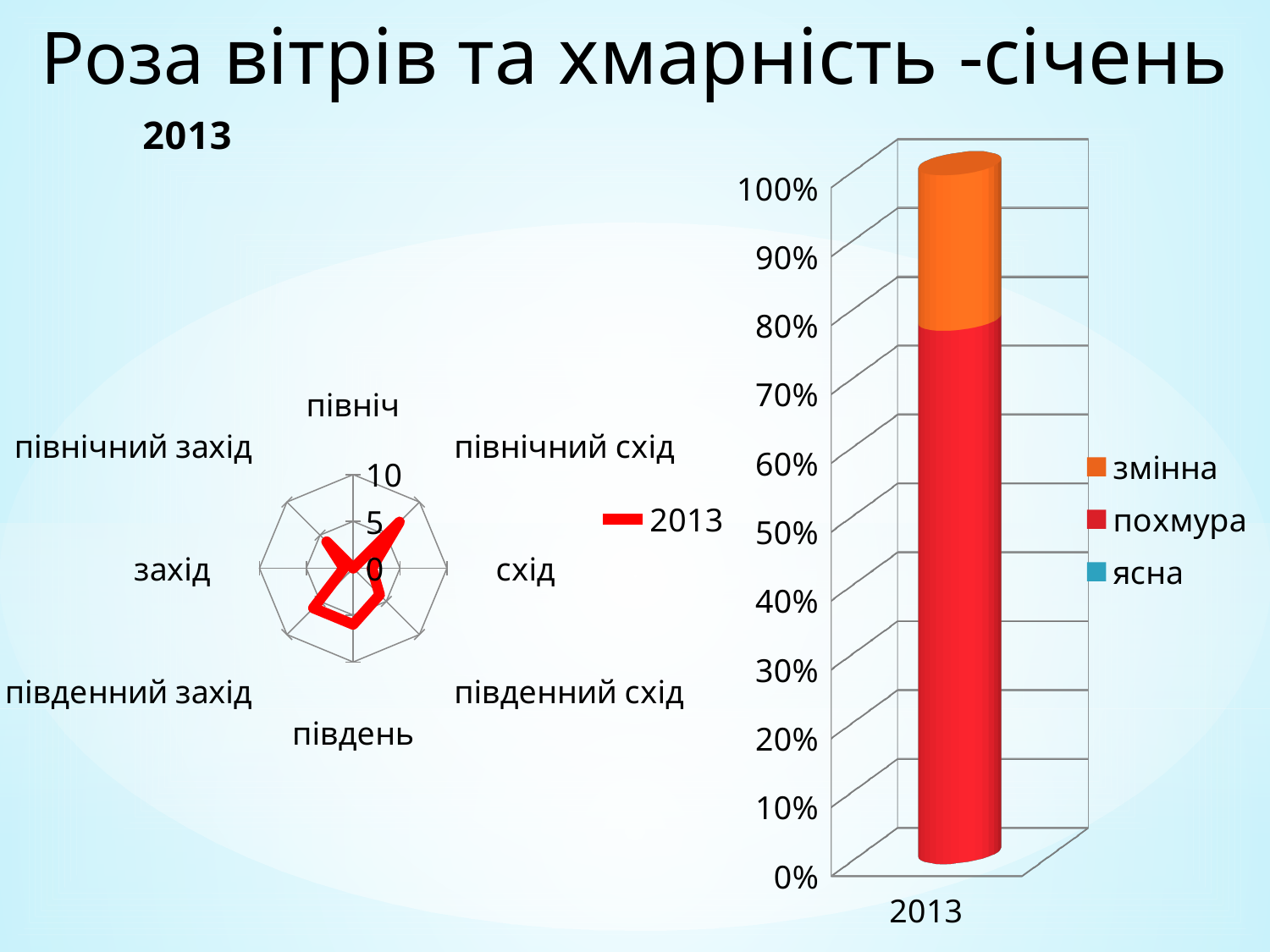
In the right-hand bar chart, is the value for похмура greater or less than 70%? greater What are the legend entries of the right-hand bar chart? змінна, похмура, ясна What kind of chart is the chart on the right side of the slide? bar chart What kind of chart is the chart on the left side of the slide (titled 2013)? radar chart In the right-hand bar chart, which series takes up the largest part of the 2013 bar? похмура How many series does the legend of the right-hand bar chart list? 3 How many series does the legend of the left-hand radar chart list? 1 In the right-hand bar chart, is the value for змінна greater or less than 30%? less How many categories are shown on the x axis of the right-hand bar chart? 1 In the right-hand bar chart, is the value for похмура greater or less than 90%? less In the left-hand radar chart, which direction has the highest value? північний схід How many direction categories does the left-hand radar chart have? 8